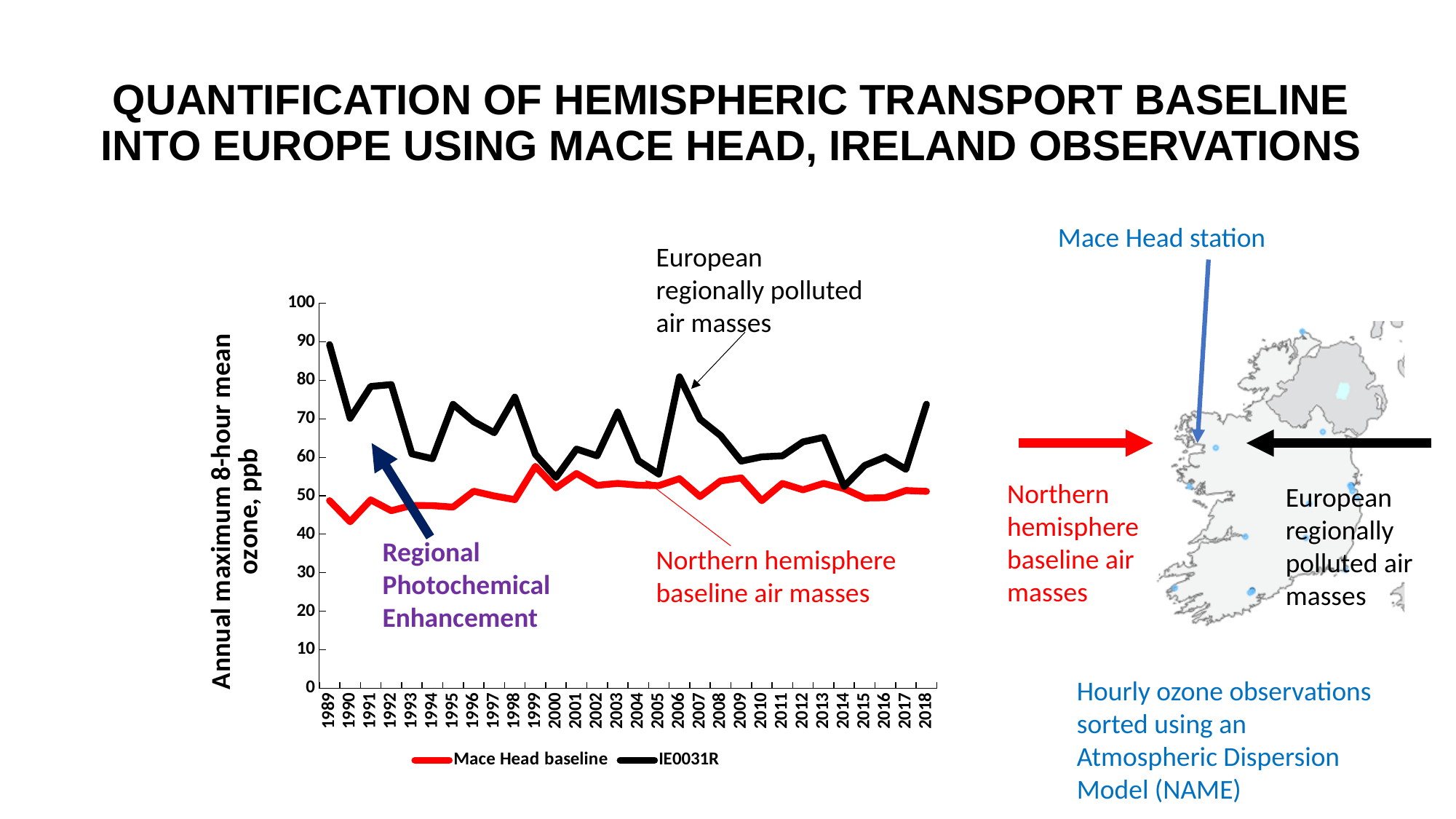
What kind of chart is shown on the slide? line chart What are the two series named in the chart legend? Mace Head baseline and IE0031R In which year is the IE0031R series at its highest? 1989 What is the label of the chart's vertical axis? Annual maximum 8-hour mean ozone, ppb In 1989, which series has the larger value, Mace Head baseline or IE0031R? IE0031R In which year is the Mace Head baseline series at its lowest? 1990 How many series does the chart legend list? 2 In which year is the IE0031R series at its lowest? 2014 Is the IE0031R value for 1989 greater or less than 80? greater How many years are plotted along the x axis of the chart? 30 Is the IE0031R value for 2018 greater or less than 70? greater Is the Mace Head baseline value for 1990 greater or less than 50? less